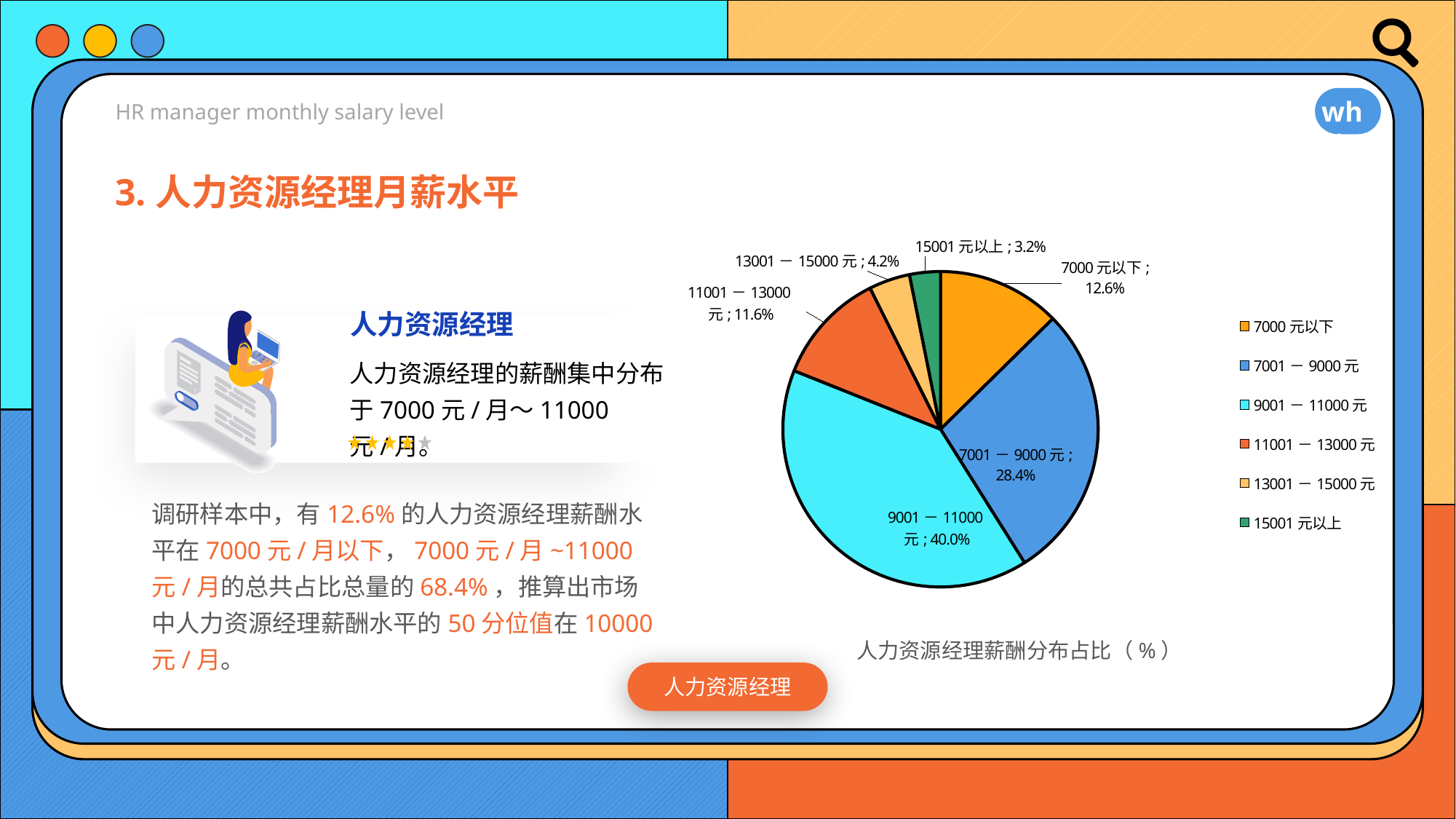
What is the share for the 11001－13000 元 slice in the pie chart? 11.6% What is the share for the 9001－11000 元 slice in the pie chart? 40.0% What is the difference in percentage points between the 9001－11000 元 slice and the 7001－9000 元 slice? 11.6 Which category has the largest slice in the pie chart? 9001－11000 元 What is the share for the 15001 元以上 slice in the pie chart? 3.2% What kind of chart is shown on the slide? pie chart What is the combined share of the 7001－9000 元 and 9001－11000 元 slices? 68.4% What is the title of the pie chart? 人力资源经理薪酬分布占比（%） Which slice is larger: 13001－15000 元 or 15001 元以上? 13001－15000 元 Which category has the smallest slice in the pie chart? 15001 元以上 What is the share for the 7000 元以下 slice in the pie chart? 12.6% How many slices does the pie chart have? 6